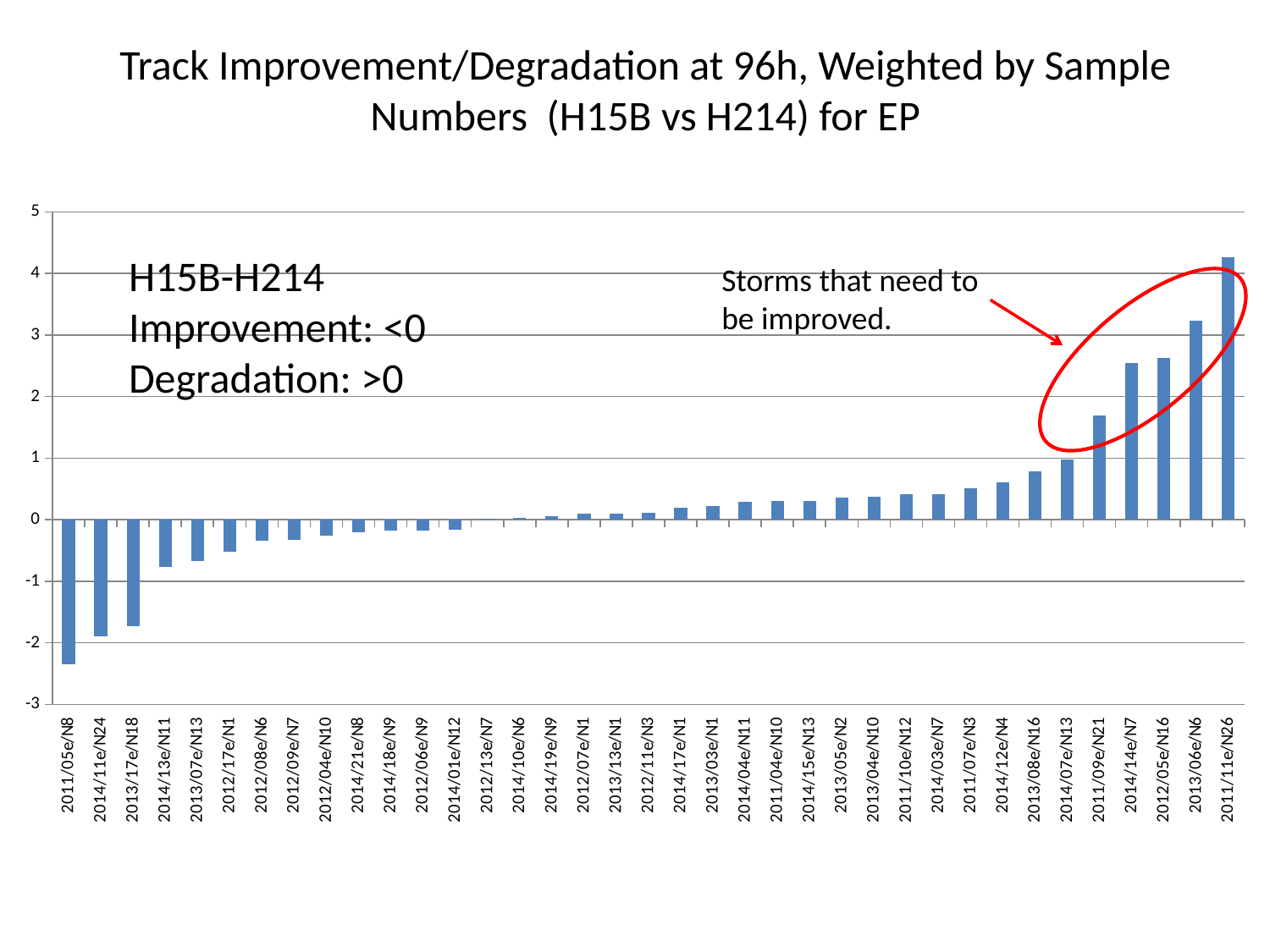
Which storm has the highest value in the chart? 2011/11e/N26 Is the value for 2013/06e/N6 greater or less than 3? greater Is the value for 2011/05e/N8 greater or less than -2? less Which has the larger value, 2013/06e/N6 or 2014/14e/N7? 2013/06e/N6 How many storms (categories) are plotted along the x axis? 37 Which storm has the lowest value in the chart? 2011/05e/N8 Do the bar values rise or fall moving from left to right along the x axis? rise Is the value for 2014/11e/N24 greater or less than -1? less What kind of chart is shown on the slide? bar chart According to the text on the chart, does a value below 0 indicate improvement or degradation? Improvement